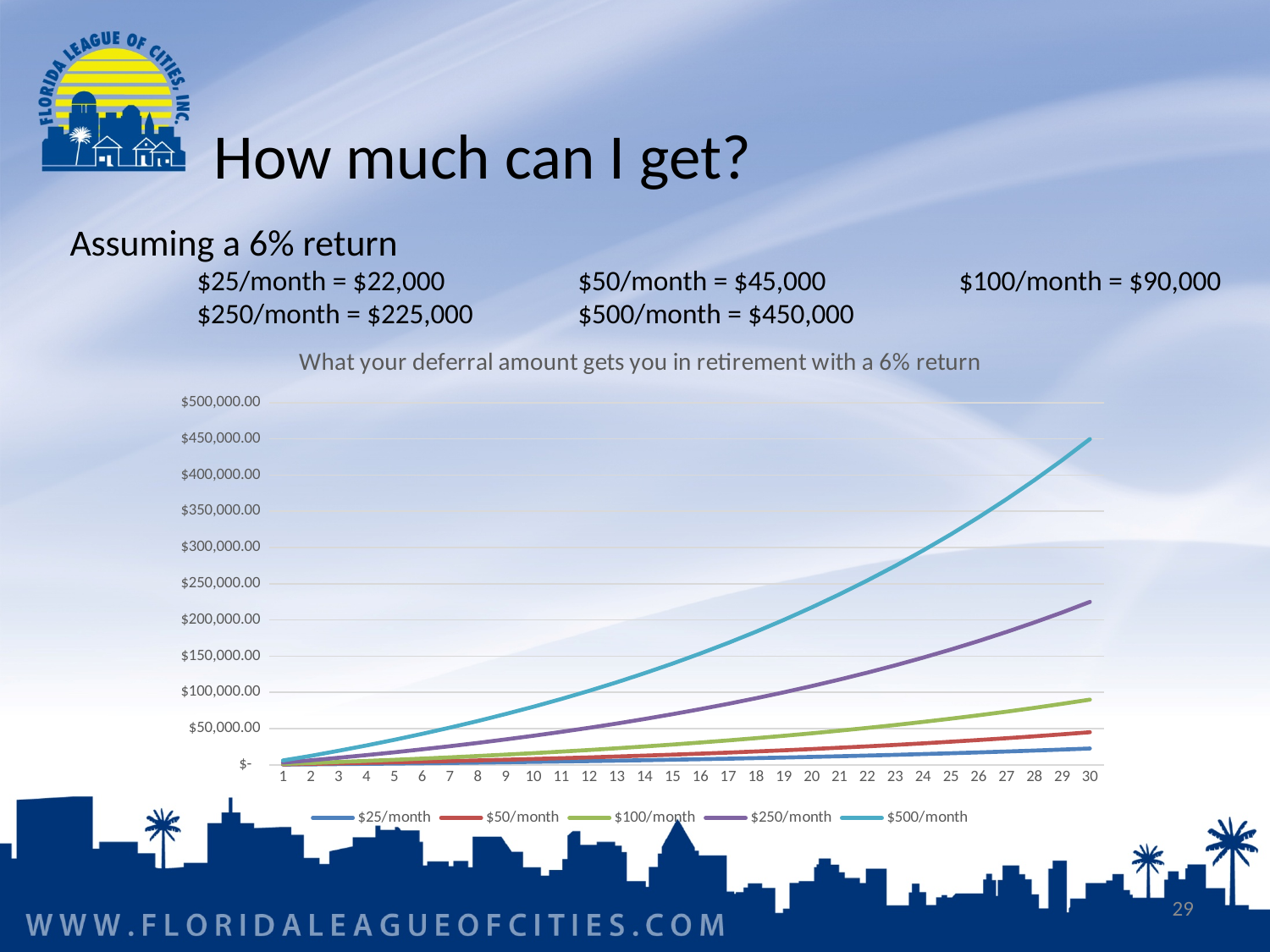
How many series does the chart legend list? 5 Do the values of the $500/month series rise or fall as the years increase along the x axis? rise Which series has the lowest value at year 30? $25/month How many points (years) are shown along the x axis of the chart? 30 Is the value for the $500/month series at year 20 greater or less than $150,000? greater What colour is the line for the $50/month series? red Is the value for the $250/month series at year 30 greater or less than $200,000? greater What kind of chart is shown on the slide? line chart At year 30, which is larger: the $250/month series or the $100/month series? $250/month What is the title of the chart? What your deferral amount gets you in retirement with a 6% return Is the value for the $100/month series at year 30 greater or less than $100,000? less Which series has the highest value at year 30? $500/month